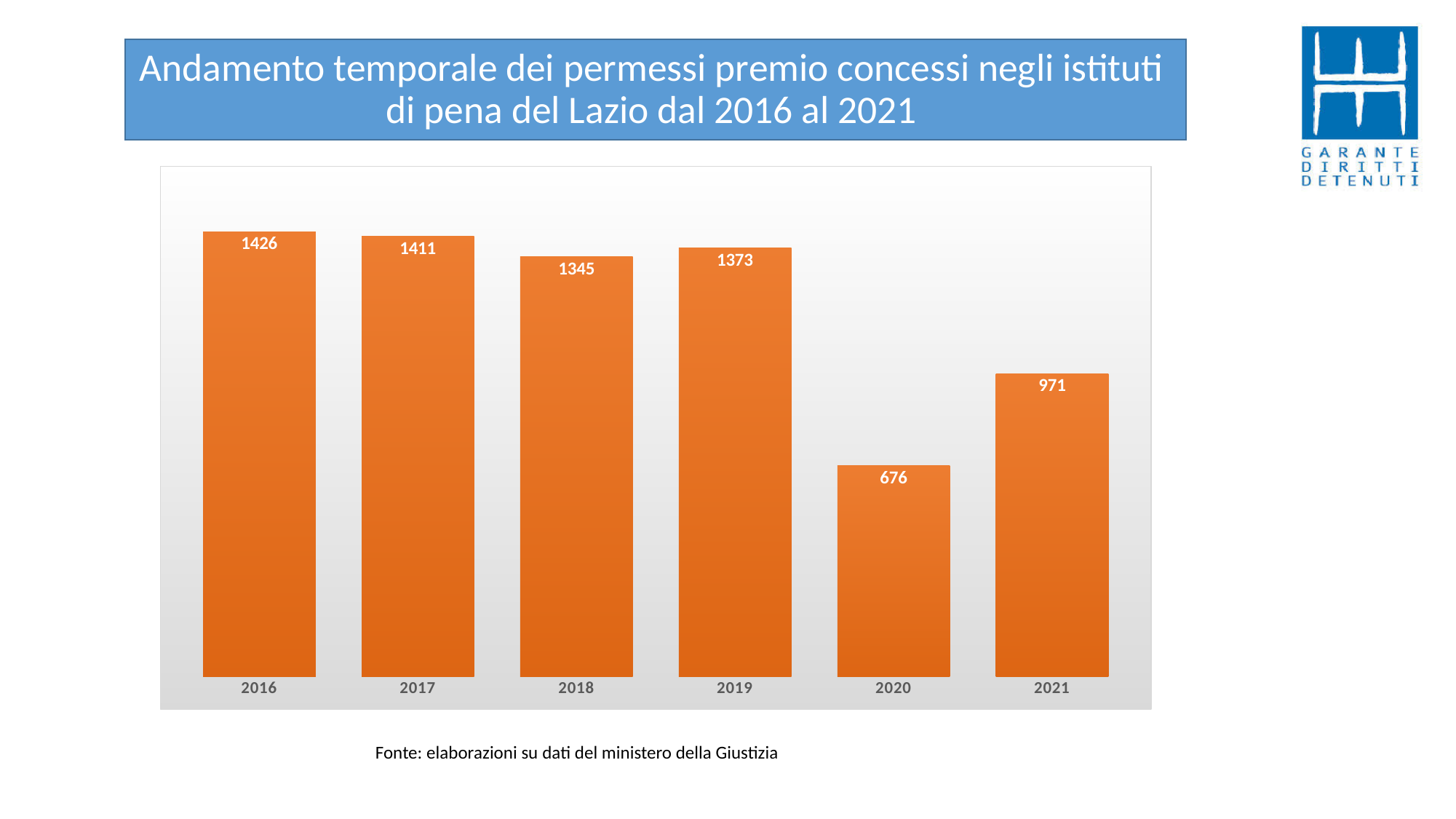
Do the values rise or fall from 2019 to 2020? fall What is the value for 2016? 1426 Which year has the lowest value? 2020 Which year has the highest value? 2016 How many years are shown on the x axis? 6 What is the source cited below the chart? Fonte: elaborazioni su dati del ministero della Giustizia Which is larger, the value for 2018 or the value for 2019? 2019 What is the difference between the values for 2016 and 2017? 15 What kind of chart is shown on the slide? bar chart What is the value for 2020? 676 What is the difference between the values for 2019 and 2020? 697 What is the value for 2021? 971